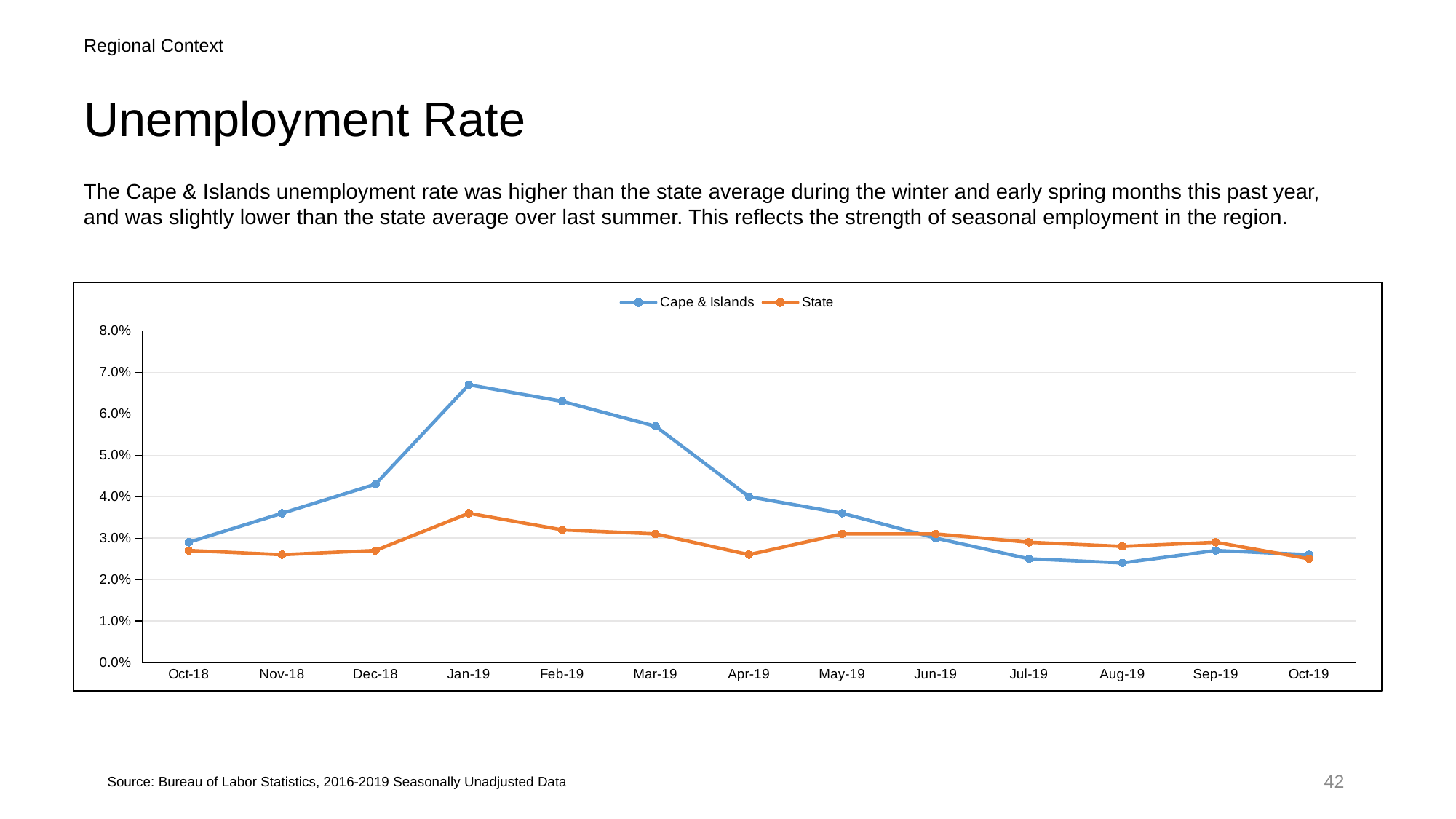
In which month does the Cape & Islands unemployment rate reach its highest point? Jan-19 What colour is the State line in the chart? Orange Which series has the higher value in Jan-19, Cape & Islands or State? Cape & Islands Is the State value for Jan-19 greater or less than 3.0%? greater Is the Cape & Islands value for Aug-19 greater or less than 3.0%? less Is the Cape & Islands value for Jan-19 greater or less than 6.0%? greater How many months are plotted along the x axis? 13 What kind of chart is shown on the slide? Line chart Does the Cape & Islands line rise or fall from Jan-19 to Aug-19? Fall How many series does the legend list? 2 In which month does the State unemployment rate reach its highest point? Jan-19 Which series has the higher value in Aug-19, Cape & Islands or State? State